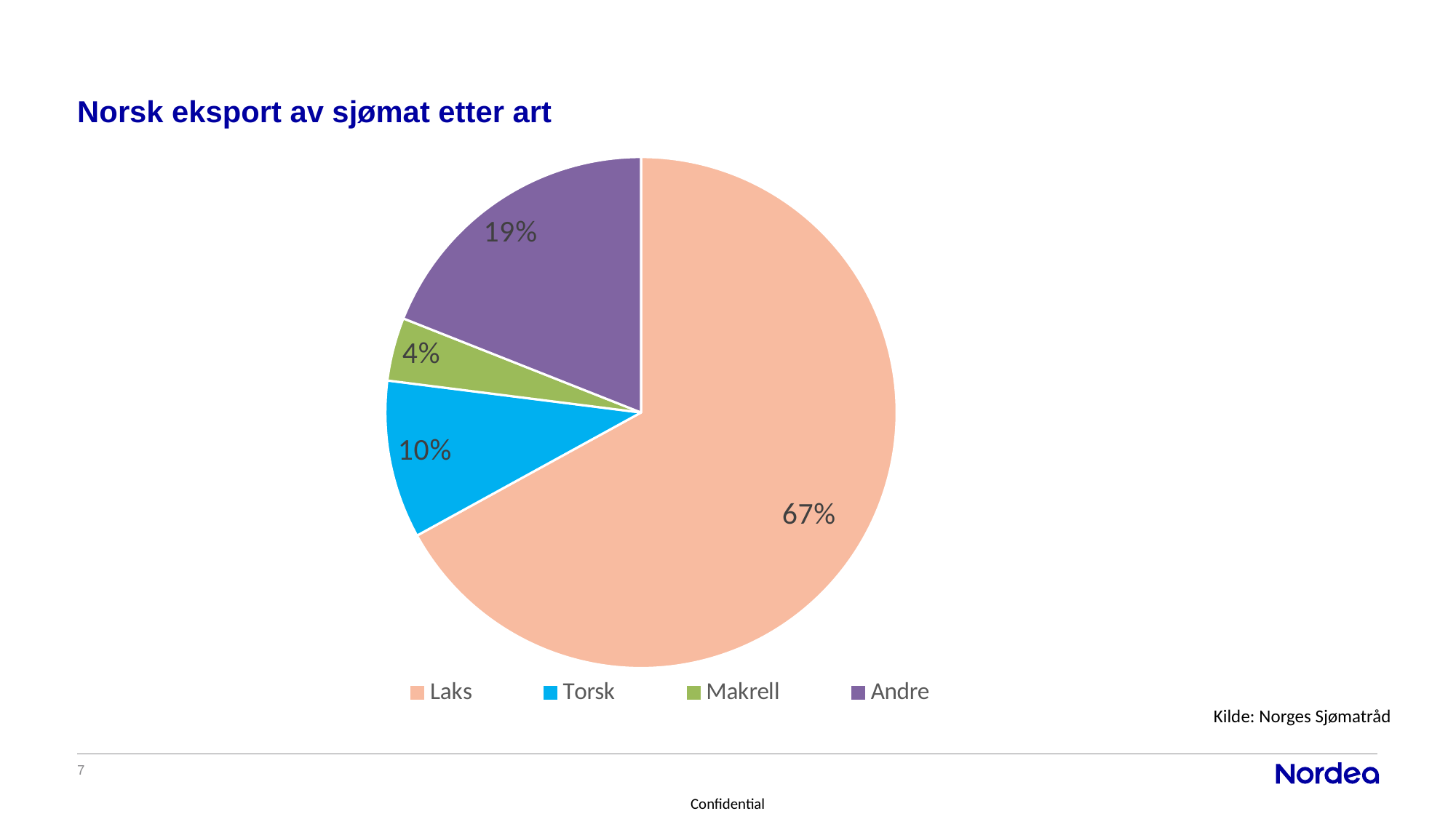
Which category has the smallest slice of the pie? Makrell What is the title of the chart? Norsk eksport av sjømat etter art Which category has the largest slice of the pie? Laks How many entries does the legend list? 4 What is the value shown for Torsk? 10% What kind of chart is shown on the slide? Pie chart What share of the pie does Laks account for? 67% What is the difference in percentage points between Andre and Torsk? 9 What is the value shown for Andre? 19% How many slices does the pie chart have? 4 What is the value shown for Makrell? 4% Which is larger, the slice for Torsk or the slice for Andre? Andre